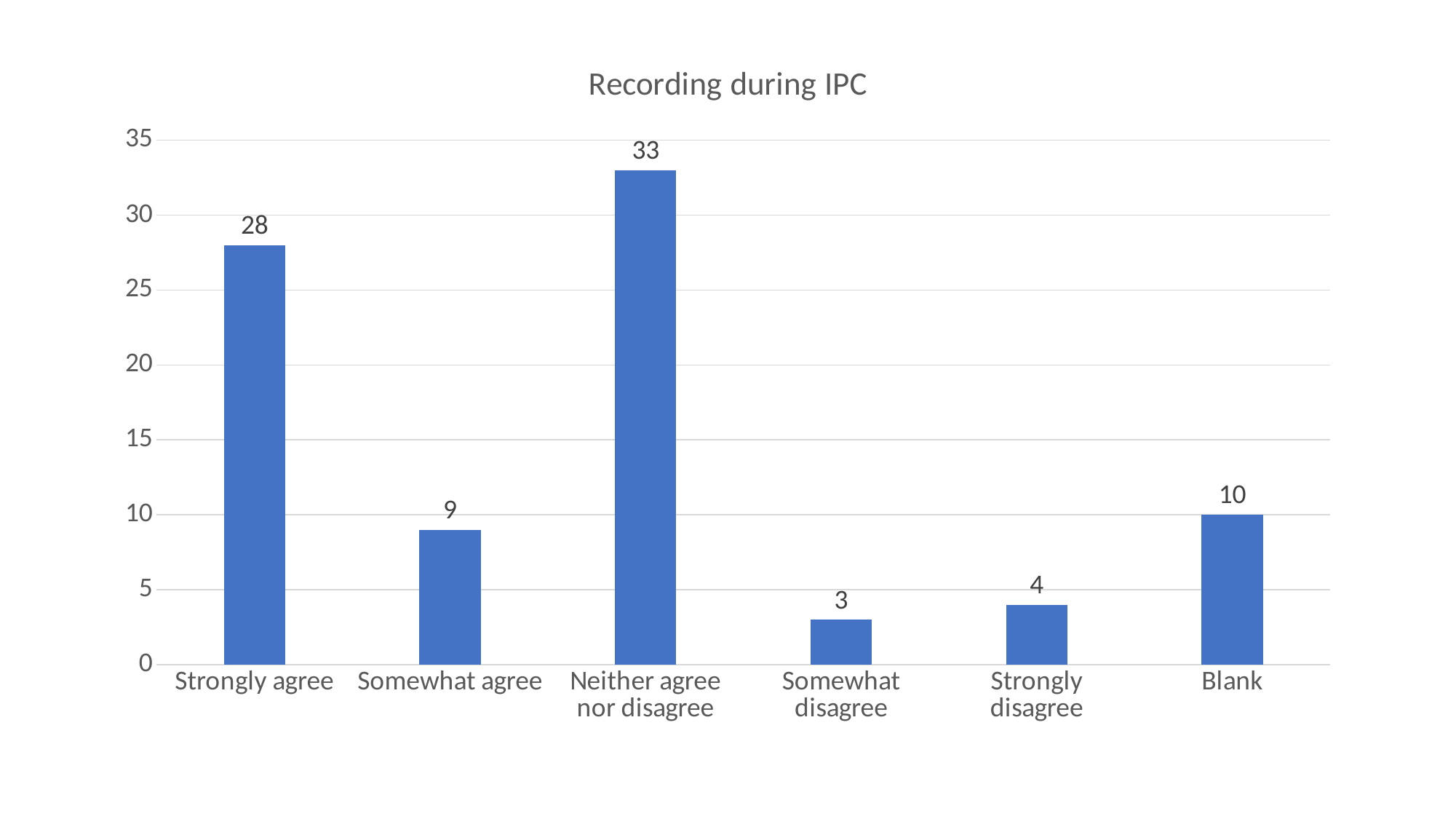
What is the value for Blank? 10 What is the value for Neither agree nor disagree? 33 Which is larger, the value for Somewhat agree or the value for Blank? Blank What is the difference between the values for Neither agree nor disagree and Strongly agree? 5 What kind of chart is this? Bar chart What is the value for Strongly agree? 28 Which category has the highest value? Neither agree nor disagree What is the value for Somewhat disagree? 3 Is the value for Strongly agree greater or less than 25? greater What is the title of the chart? Recording during IPC How many categories are shown on the x axis? 6 Which category has the lowest value? Somewhat disagree